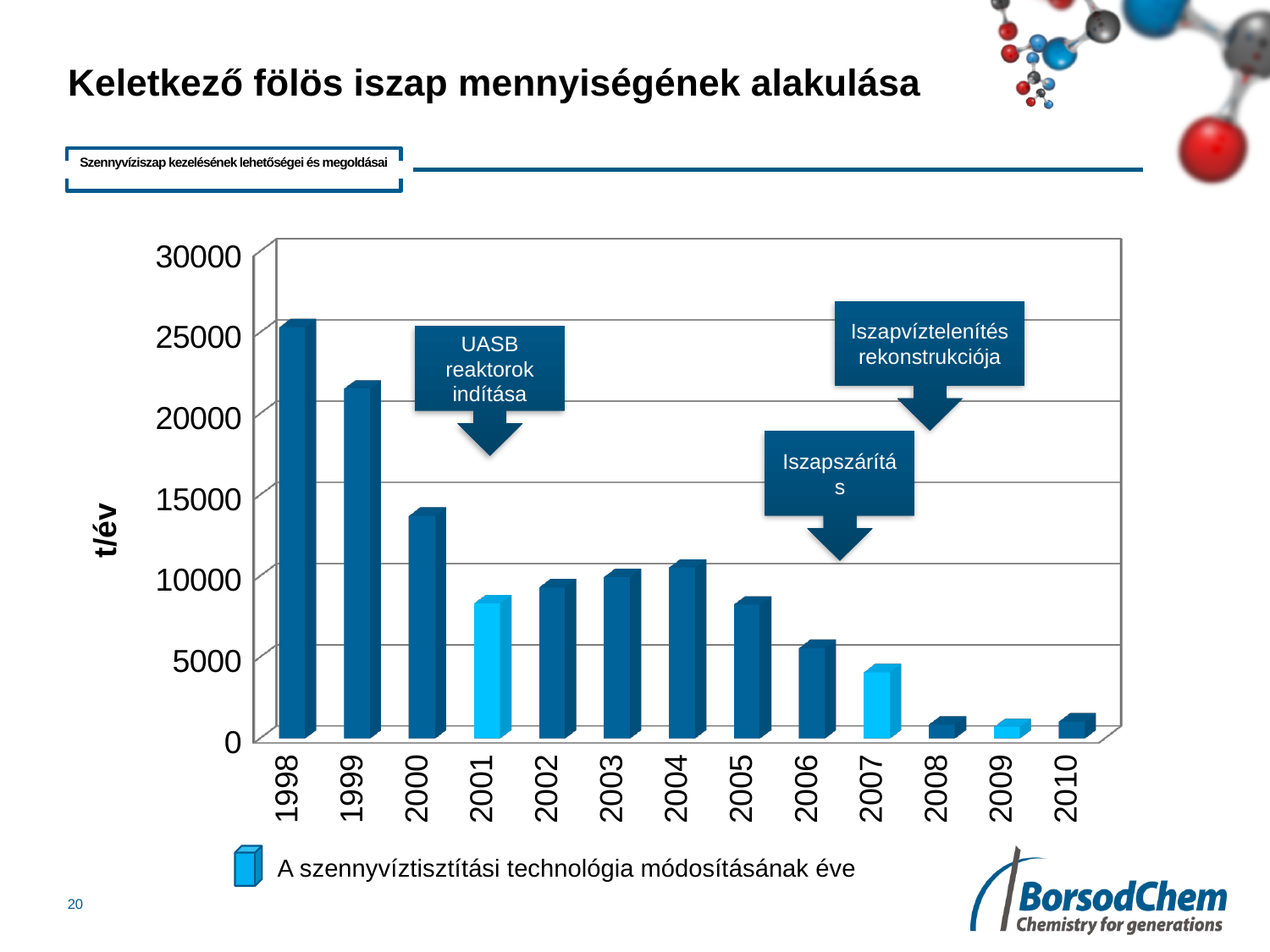
Which year has the larger value, 1998 or 1999? 1998 Is the value for 2000 greater or less than 15000? less Which year has the larger value, 2000 or 2004? 2000 How many years are shown on the x axis of the chart? 13 Is the value for 2007 greater or less than 5000? less What kind of chart is shown on the slide? bar chart Which years are shown with light blue bars in the chart? 2001, 2007, 2009 Do the values generally rise or fall from 1998 to 2010? fall Is the value for 2001 greater or less than 10000? less Which year has the highest value in the chart? 1998 What is the label on the y axis of the chart? t/év